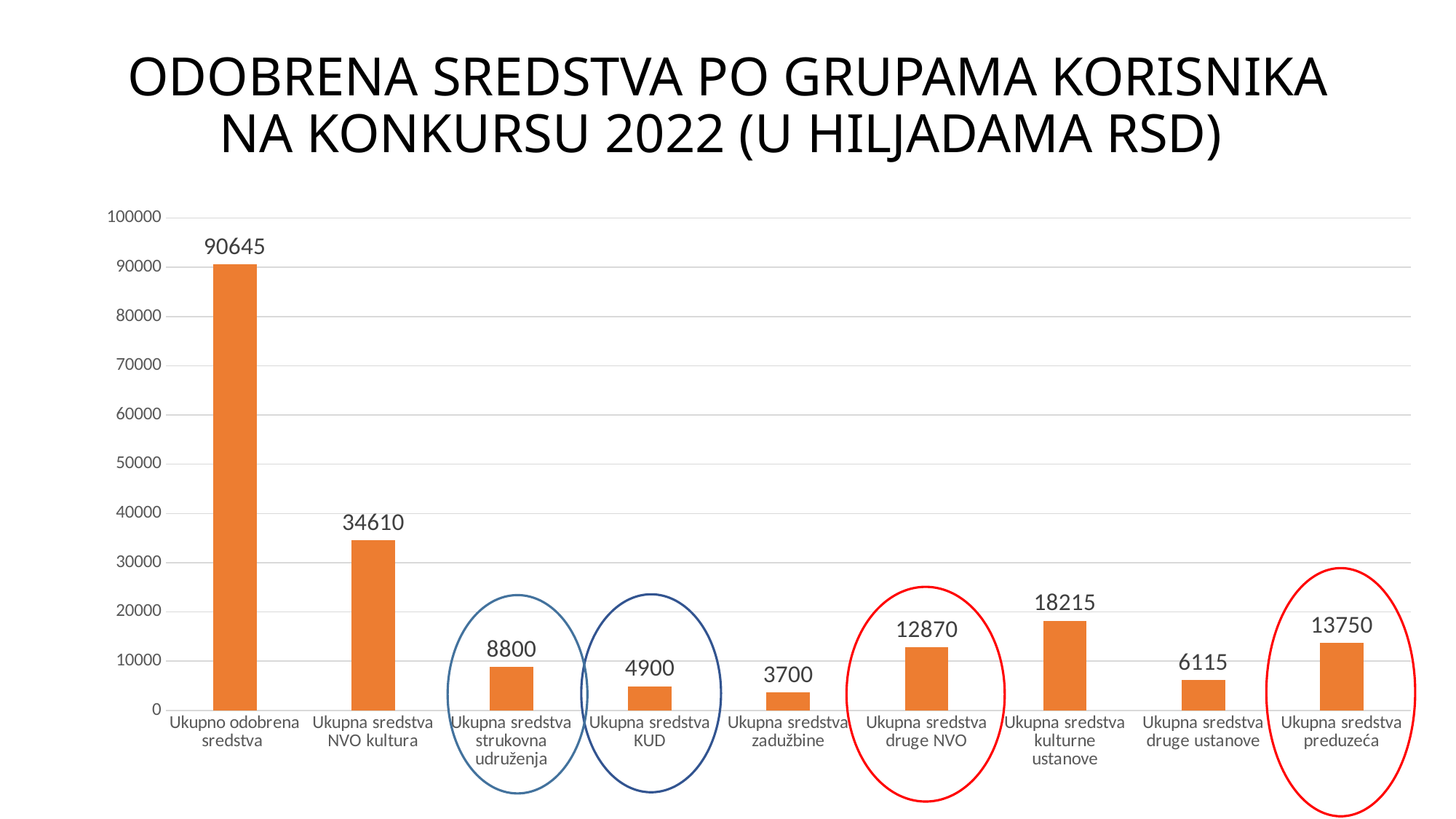
How many categories are shown on the chart? 9 Is the value for Ukupna sredstva NVO kultura greater or less than 30000? greater What is the difference between Ukupna sredstva kulturne ustanove and Ukupna sredstva druge NVO? 5345 Which category has the highest value? Ukupno odobrena sredstva Which is larger: Ukupna sredstva strukovna udruženja or Ukupna sredstva druge ustanove? Ukupna sredstva strukovna udruženja What kind of chart is shown on the slide? bar chart What is the value for Ukupna sredstva NVO kultura? 34610 What is the value for Ukupna sredstva KUD? 4900 What is the value for Ukupna sredstva preduzeća? 13750 What is the title of the chart? ODOBRENA SREDSTVA PO GRUPAMA KORISNIKA NA KONKURSU 2022 (U HILJADAMA RSD) Which category has the lowest value? Ukupna sredstva zadužbine What is the value for Ukupna sredstva kulturne ustanove? 18215